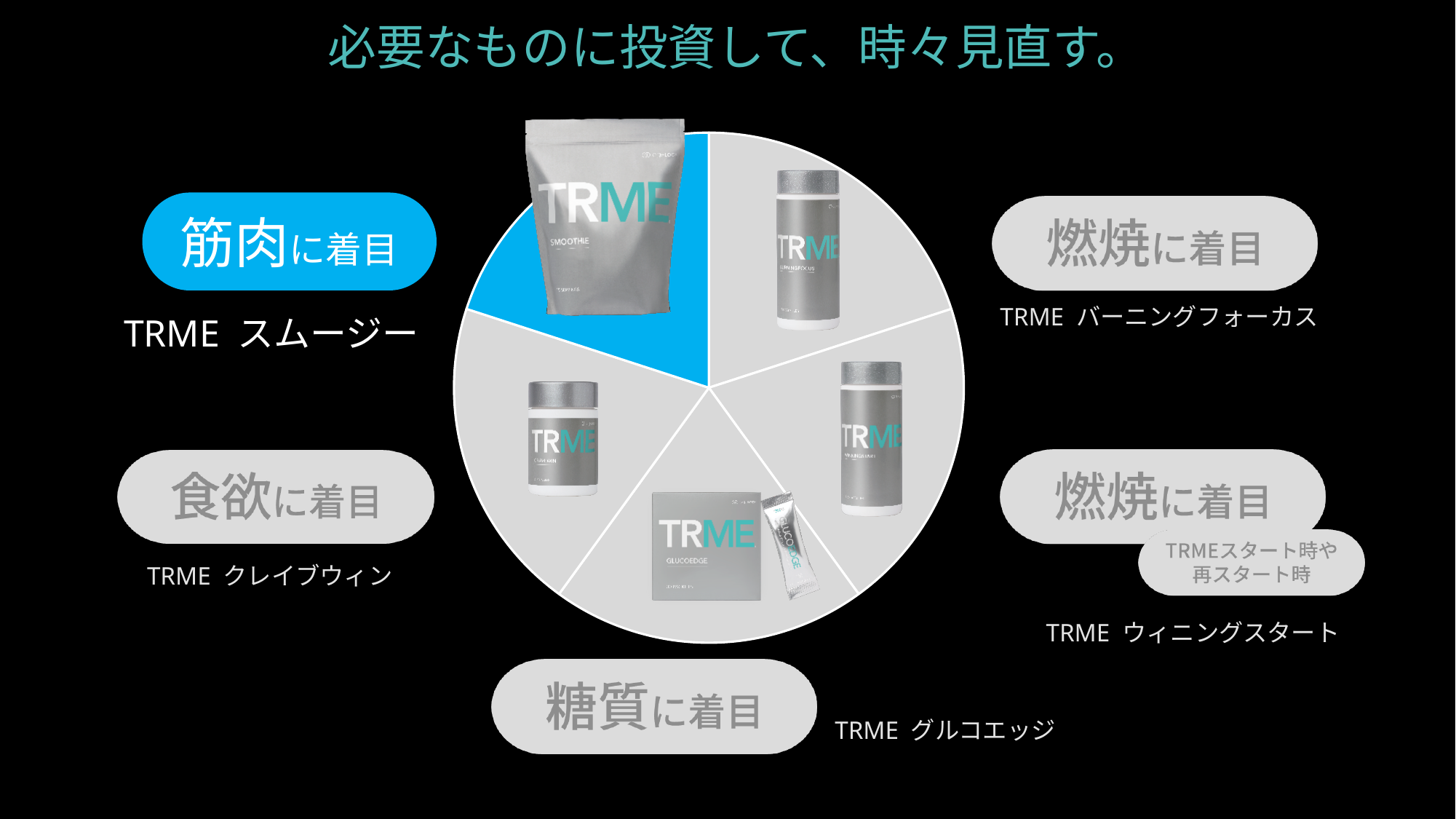
How many of the pie chart's slices are coloured blue? 1 Which product is labelled with 糖質に着目 below the pie chart? TRME グルコエッジ What kind of chart is shown in the centre of the slide? pie chart Which product is shown in the blue-highlighted slice of the pie chart? TRME スムージー Which product is labelled with 食欲に着目 on the left of the pie chart? TRME クレイブウィン How many slices does the pie chart have? 5 How many products on the slide are labelled 燃焼に着目? 2 What is the title text at the top of the slide? 必要なものに投資して、時々見直す。 Which focus label is attached to the blue slice of the pie chart? 筋肉に着目